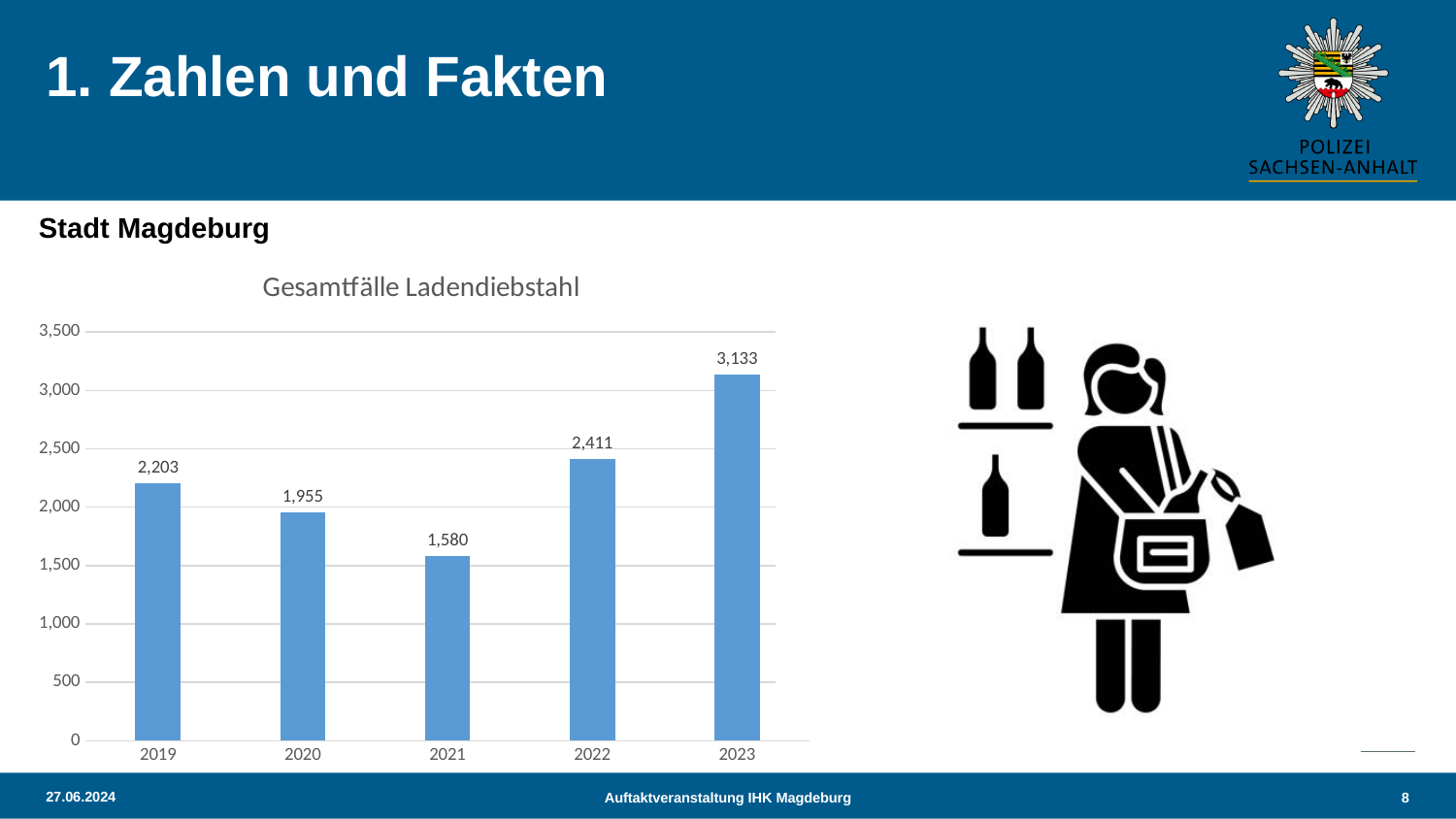
Which is larger, the value for 2020 or the value for 2022? 2022 Is the value for 2021 greater or less than 2,000? less What is the value for 2021 in the chart? 1,580 How many years are shown on the x axis? 5 What is the difference between the values for 2023 and 2022? 722 What is the value for 2019 in the chart? 2,203 What kind of chart is shown on the slide? bar chart Which year has the lowest value? 2021 Which year has the highest value? 2023 What is the title of the chart? Gesamtfälle Ladendiebstahl What is the difference between the values for 2019 and 2020? 248 What is the value for 2023 in the chart? 3,133